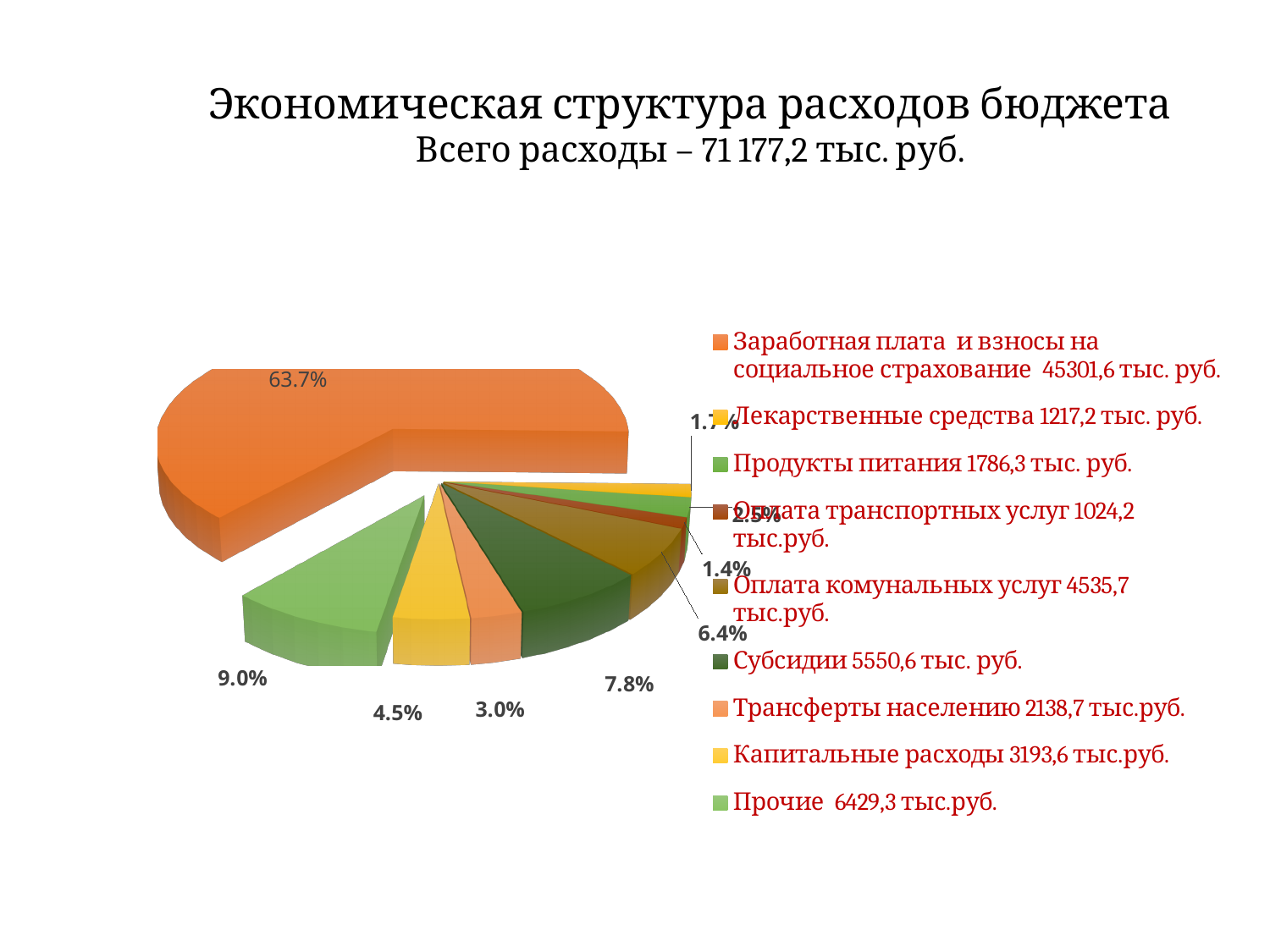
According to the legend, what is the amount for "Оплата коммунальных услуг"? 4535,7 тыс.руб. Which category has the largest slice of the pie? Заработная плата и взносы на социальное страхование What is the difference in percentage points between the "Прочие" slice and the "Капитальные расходы" slice? 4.5 How many categories does the legend of the pie chart list? 9 What share of the pie does "Прочие" take? 9.0% What share of the pie does "Заработная плата и взносы на социальное страхование" take? 63.7% What total expenditure is stated in the chart title? 71 177,2 тыс. руб. Which slice is larger: "Субсидии" or "Оплата коммунальных услуг"? Субсидии Which category has the smallest slice of the pie? Оплата транспортных услуг What share of the pie does "Капитальные расходы" take? 4.5% What kind of chart is shown on the slide? pie chart